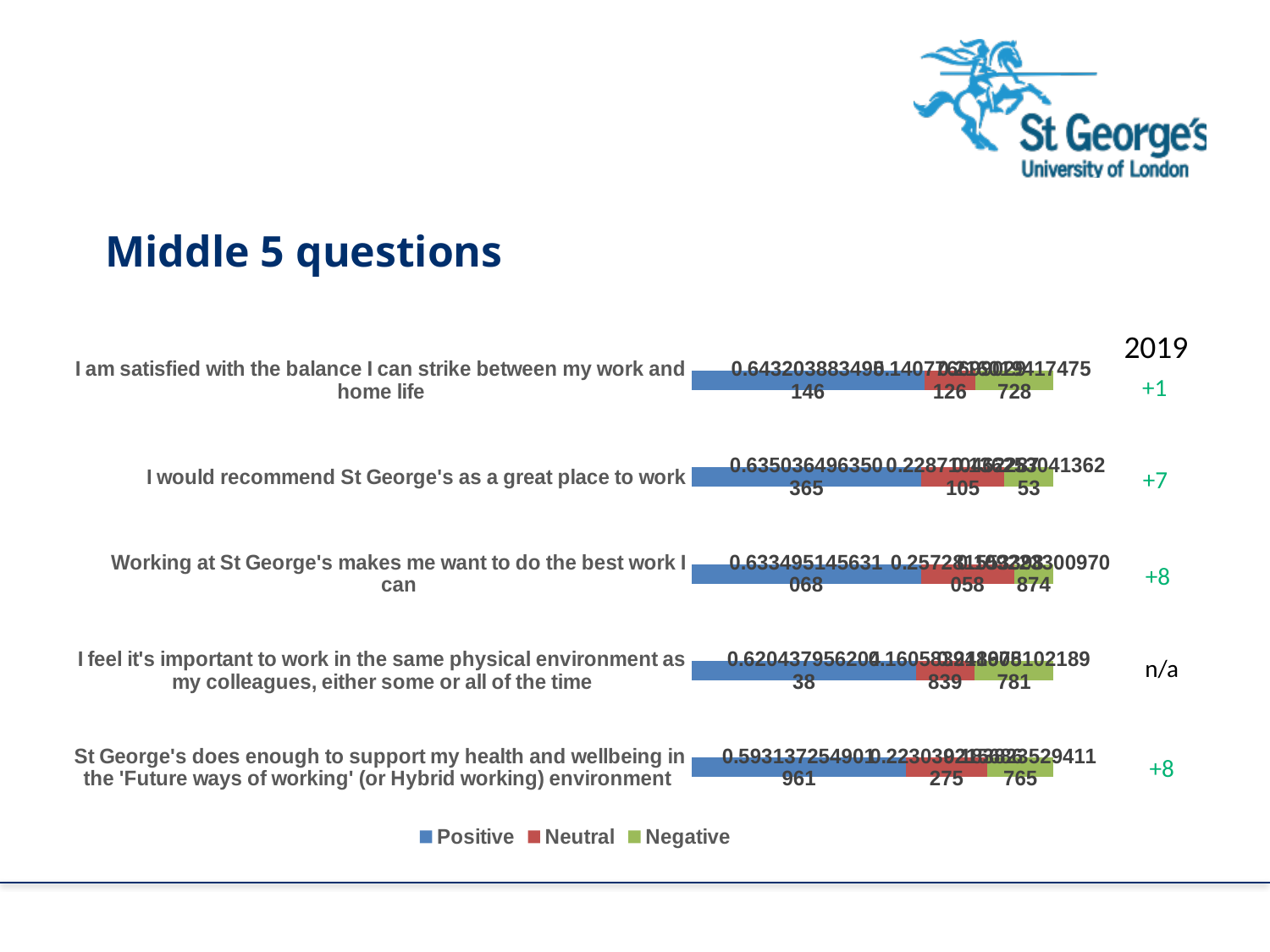
How many questions (categories) are plotted in the chart? 5 What change versus 2019 is shown next to 'I am satisfied with the balance I can strike between my work and home life'? +1 For 'I would recommend St George's as a great place to work', which is larger: the Positive share or the Negative share? Positive What is the title of the slide containing the chart? Middle 5 questions For 'I would recommend St George's as a great place to work', which is larger: the Neutral share or the Negative share? Neutral What change versus 2019 is shown next to 'I would recommend St George's as a great place to work'? +7 How many series does the chart legend list? 3 What change versus 2019 is shown next to 'I feel it's important to work in the same physical environment as my colleagues, either some or all of the time'? n/a For 'I am satisfied with the balance I can strike between my work and home life', which series has the largest share? Positive What are the three series named in the legend? Positive, Neutral, Negative For 'Working at St George's makes me want to do the best work I can', which series has the smallest share? Negative What kind of chart is shown on the slide? Stacked bar chart